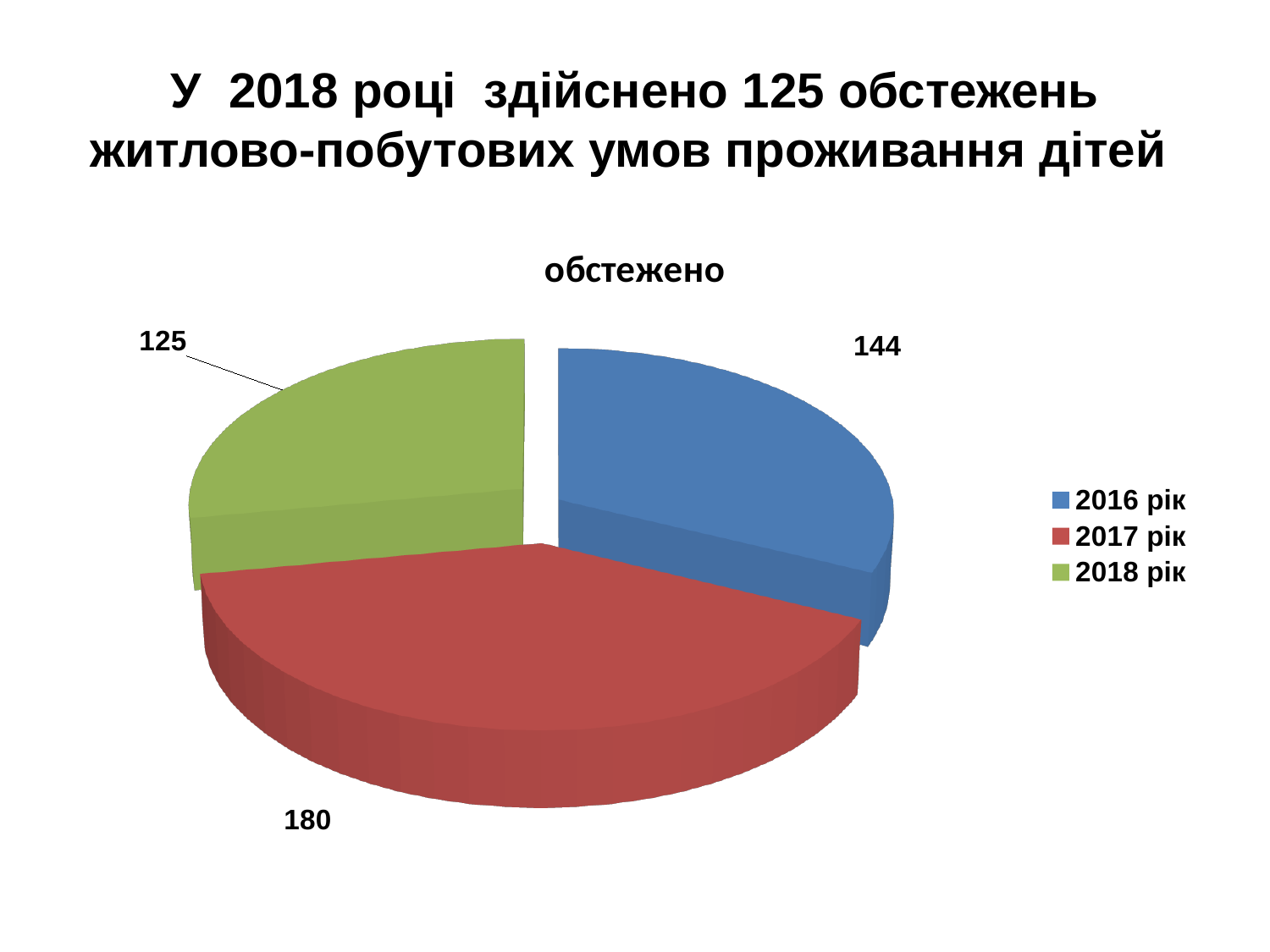
What is the value for 2018 рік? 125 What is the total of all three slices? 449 What is the difference between the values for 2017 рік and 2018 рік? 55 How many slices does the pie chart have? 3 Which is larger, the value for 2016 рік or the value for 2018 рік? 2016 рік What is the title of the chart? обстежено Which year has the smallest slice? 2018 рік Which year has the largest slice? 2017 рік What is the value for 2016 рік? 144 What type of chart is shown on the slide? pie chart How many entries does the legend list? 3 What is the value for 2017 рік? 180